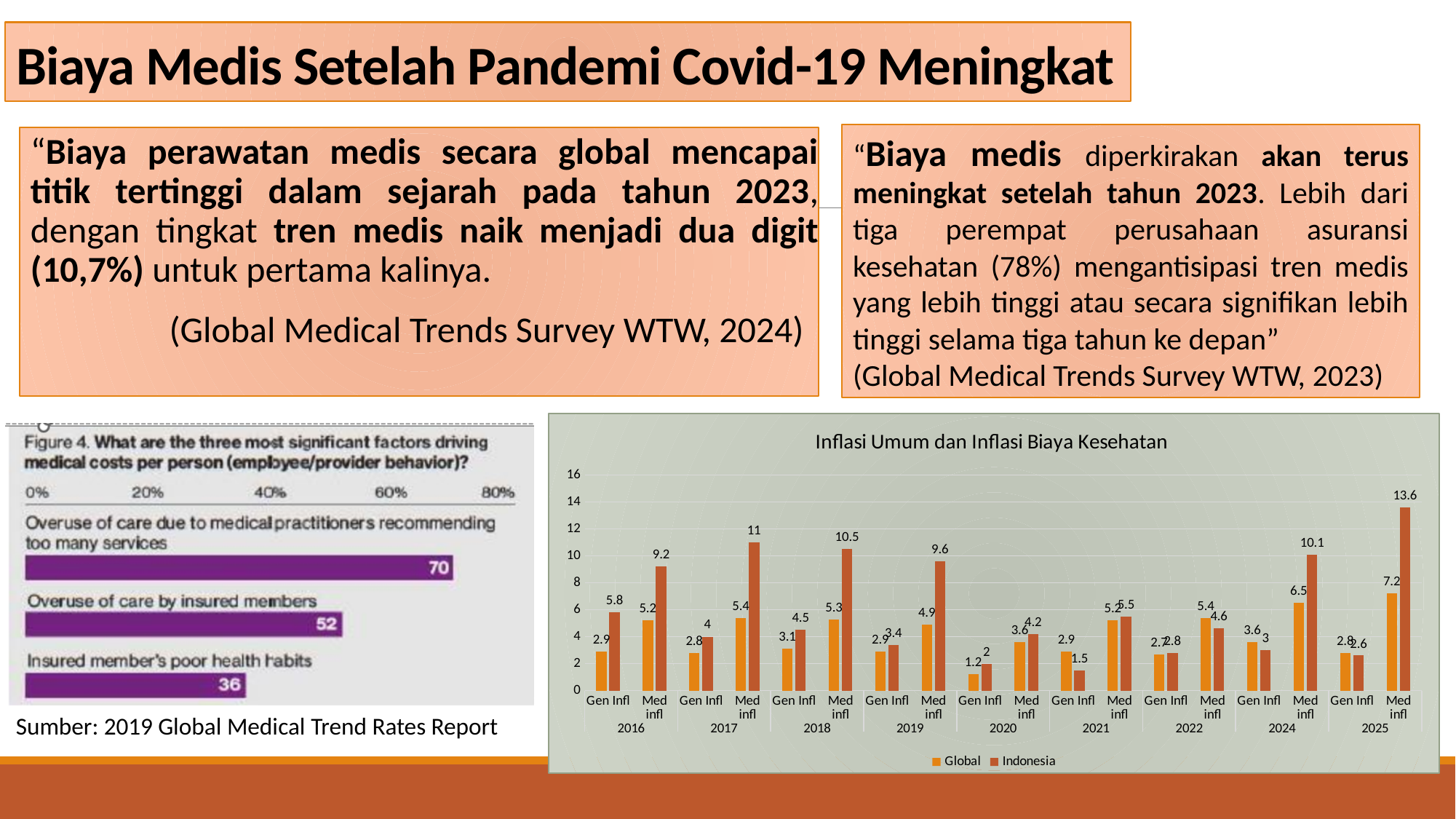
In the chart titled "Inflasi Umum dan Inflasi Biaya Kesehatan", how many series does the legend list? 2 In the chart titled "Inflasi Umum dan Inflasi Biaya Kesehatan", what is the Indonesia value for Med infl in 2025? 13.6 In the chart titled "Inflasi Umum dan Inflasi Biaya Kesehatan", what is the Global value for Med infl in 2024? 6.5 In the chart titled "Inflasi Umum dan Inflasi Biaya Kesehatan", what is the difference between the Indonesia and Global Med infl values in 2017? 5.6 In the chart titled "Inflasi Umum dan Inflasi Biaya Kesehatan", what colour represents the Indonesia series? Dark orange/brown In the Figure 4 chart on the left, what is the difference between the values for "Overuse of care by insured members" and "Insured member's poor health habits"? 16 In the chart titled "Inflasi Umum dan Inflasi Biaya Kesehatan", which year has the lowest Global Gen Infl value? 2020 In the Figure 4 chart on the left, which factor has the lowest value? Insured member's poor health habits In the Figure 4 chart on the left, what is the value for "Overuse of care due to medical practitioners recommending too many services"? 70 In the chart titled "Inflasi Umum dan Inflasi Biaya Kesehatan", which is larger for Med infl in 2022: Global or Indonesia? Global In the chart titled "Inflasi Umum dan Inflasi Biaya Kesehatan", which year has the highest Indonesia Med infl value? 2025 In the chart titled "Inflasi Umum dan Inflasi Biaya Kesehatan", what is the Indonesia value for Gen Infl in 2016? 5.8